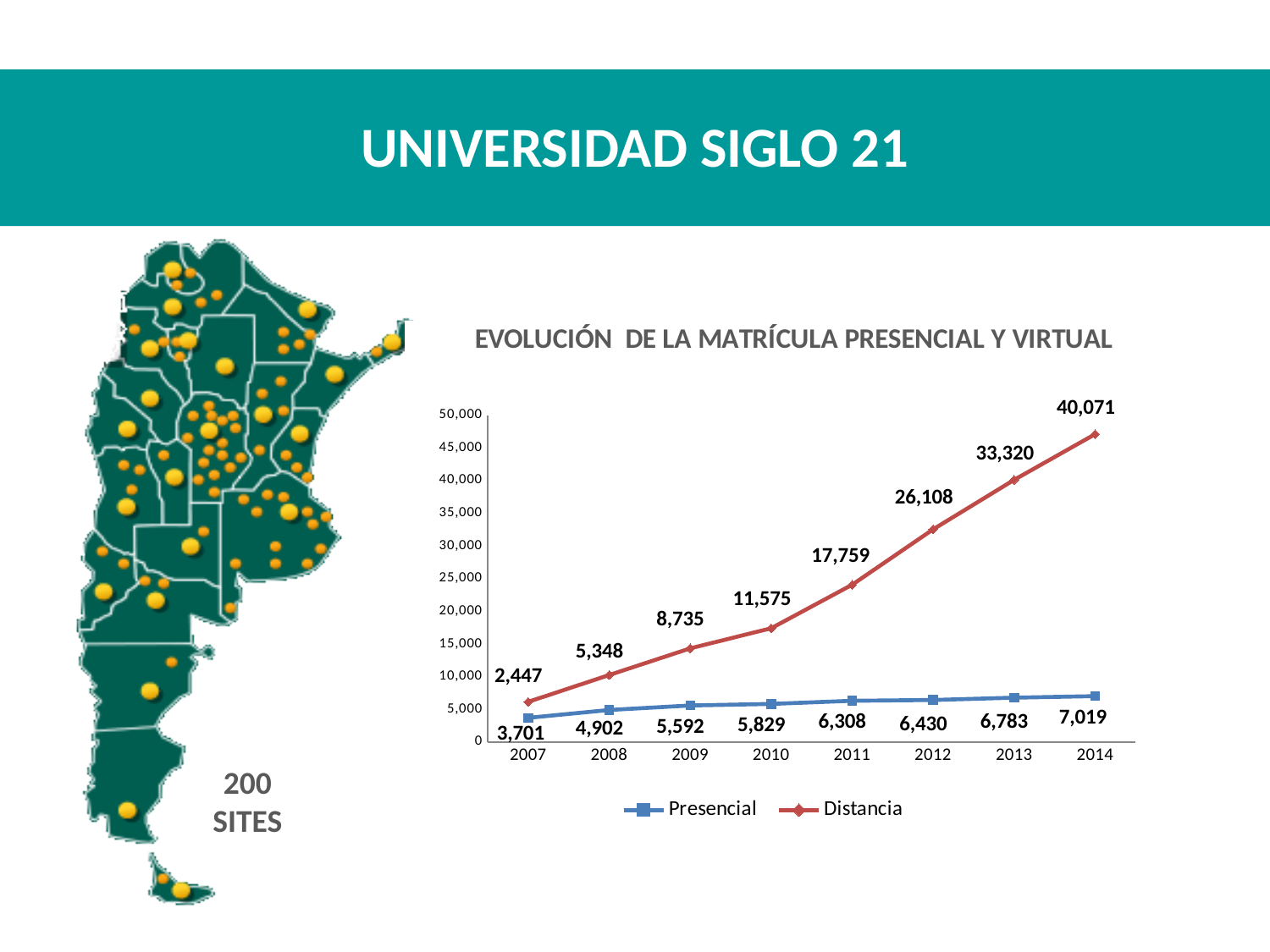
In which year is the Presencial value lowest? 2007 In which year is the Distancia value highest? 2014 What is the Distancia value for 2011? 17,759 What is the Presencial value for 2012? 6,430 Which series has the larger value in 2007, Presencial or Distancia? Presencial What is the Distancia value for 2014? 40,071 How many years are shown on the x axis? 8 What type of chart is shown on the slide? Line chart How many series does the chart legend list? 2 Does the Distancia series rise or fall from 2007 to 2014? Rise What is the difference between the Distancia and Presencial values in 2014? 33,052 What is the Presencial value for 2007? 3,701